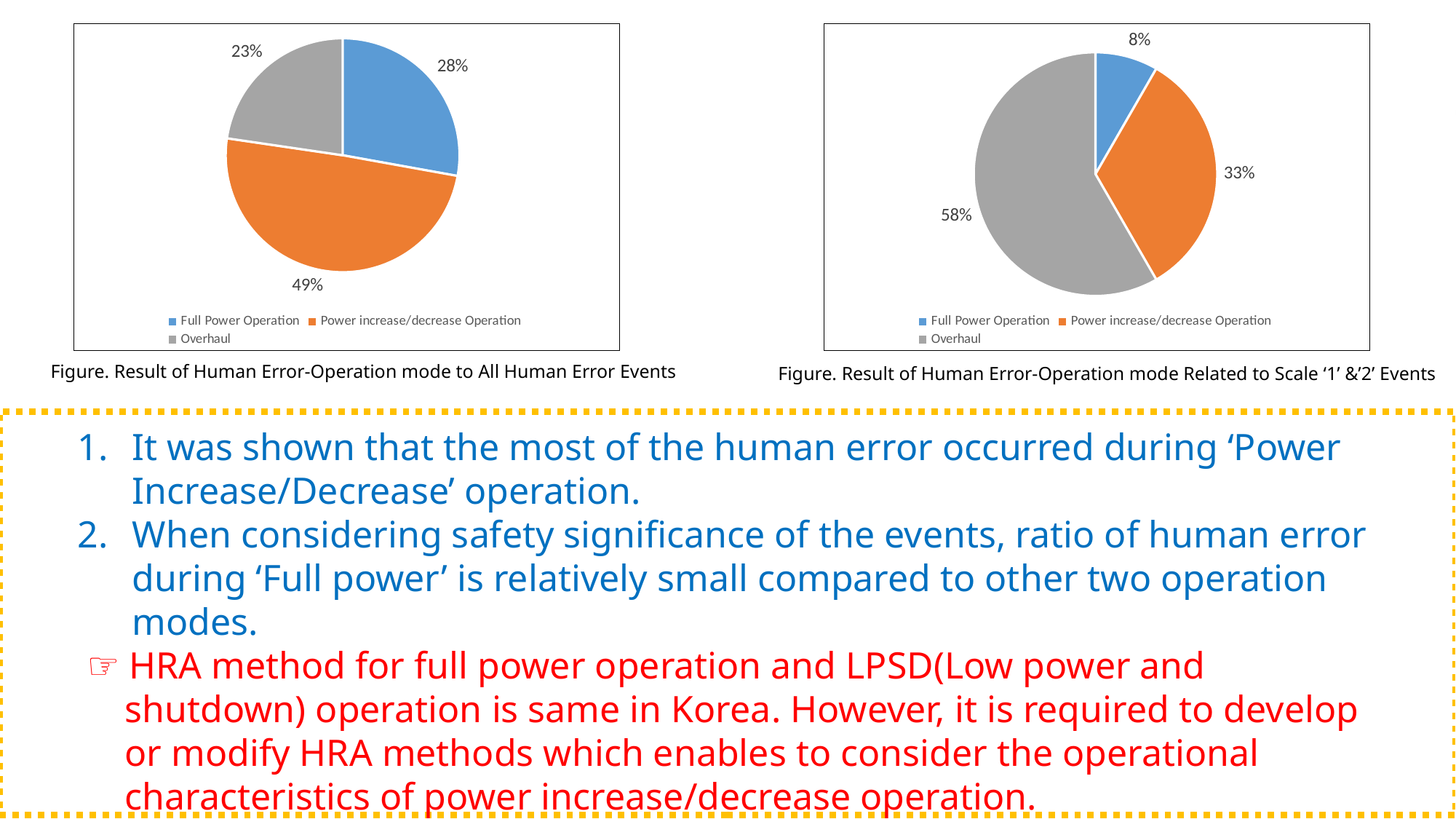
In the right pie chart, which category has the smallest slice? Full Power Operation How many slices does the right pie chart have? 3 In the left pie chart, what share is labelled for Overhaul? 23% In the left pie chart, what is the difference between the Power increase/decrease Operation share and the Overhaul share? 26% What type of chart is the left chart? Pie chart In the left pie chart, what share is labelled for Full Power Operation? 28% In the right pie chart, what share is labelled for Full Power Operation? 8% In the left pie chart, which category has the largest slice? Power increase/decrease Operation In the left pie chart, which is larger: Full Power Operation or Overhaul? Full Power Operation In the right pie chart, what is the difference between the Overhaul share and the Full Power Operation share? 50% In the right pie chart, what share is labelled for Power increase/decrease Operation? 33% In the right pie chart, which category has the largest slice? Overhaul